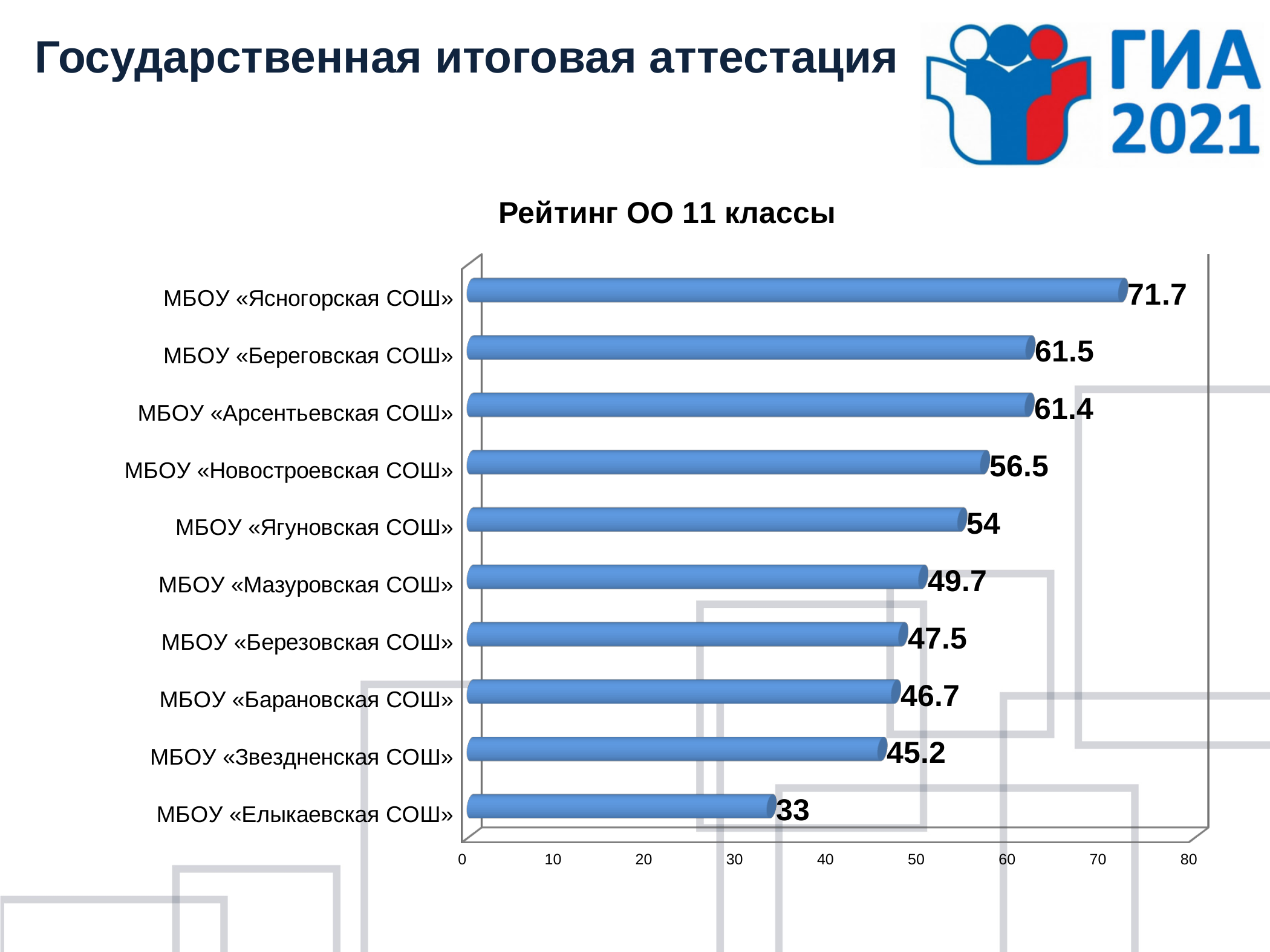
What is the value for МБОУ «Ясногорская СОШ»? 71.7 What is the value for МБОУ «Новостроевская СОШ»? 56.5 How many schools are shown in the chart? 10 Which school has the lowest value? МБОУ «Елыкаевская СОШ» Which has a larger value, МБОУ «Ягуновская СОШ» or МБОУ «Мазуровская СОШ»? МБОУ «Ягуновская СОШ» What is the difference between the values for МБОУ «Береговская СОШ» and МБОУ «Арсентьевская СОШ»? 0.1 What is the difference between the values for МБОУ «Ясногорская СОШ» and МБОУ «Елыкаевская СОШ»? 38.7 What kind of chart is shown on the slide? bar chart Is the value for МБОУ «Звездненская СОШ» greater or less than 50? less What is the title of the chart? Рейтинг ОО 11 классы Which school has the highest value? МБОУ «Ясногорская СОШ» What is the value for МБОУ «Елыкаевская СОШ»? 33